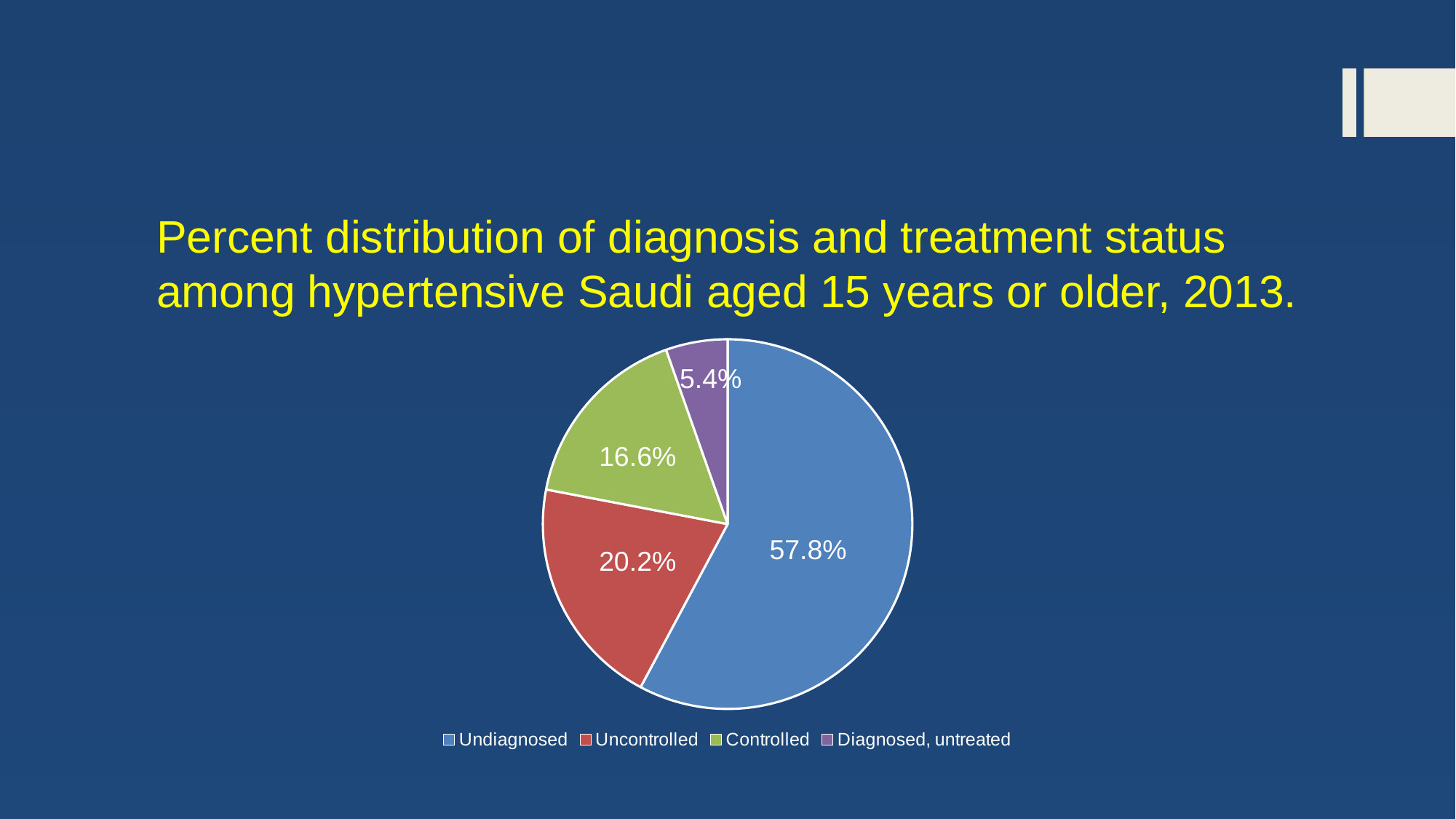
What is the difference in percentage points between the Controlled and Diagnosed, untreated slices? 11.2 What type of chart is shown on the slide? Pie chart Which category has the smallest share of the pie? Diagnosed, untreated Which category has the largest share of the pie? Undiagnosed What percentage is shown for the Diagnosed, untreated slice? 5.4% What percentage is shown for the Controlled slice? 16.6% Which is larger, the Uncontrolled slice or the Controlled slice? Uncontrolled What percentage of hypertensive Saudis are Undiagnosed? 57.8% What percentage is shown for the Uncontrolled slice? 20.2% How many categories does the pie chart show? 4 What colour is the Controlled slice in the pie chart? Green What is the difference in percentage points between the Undiagnosed and Uncontrolled slices? 37.6